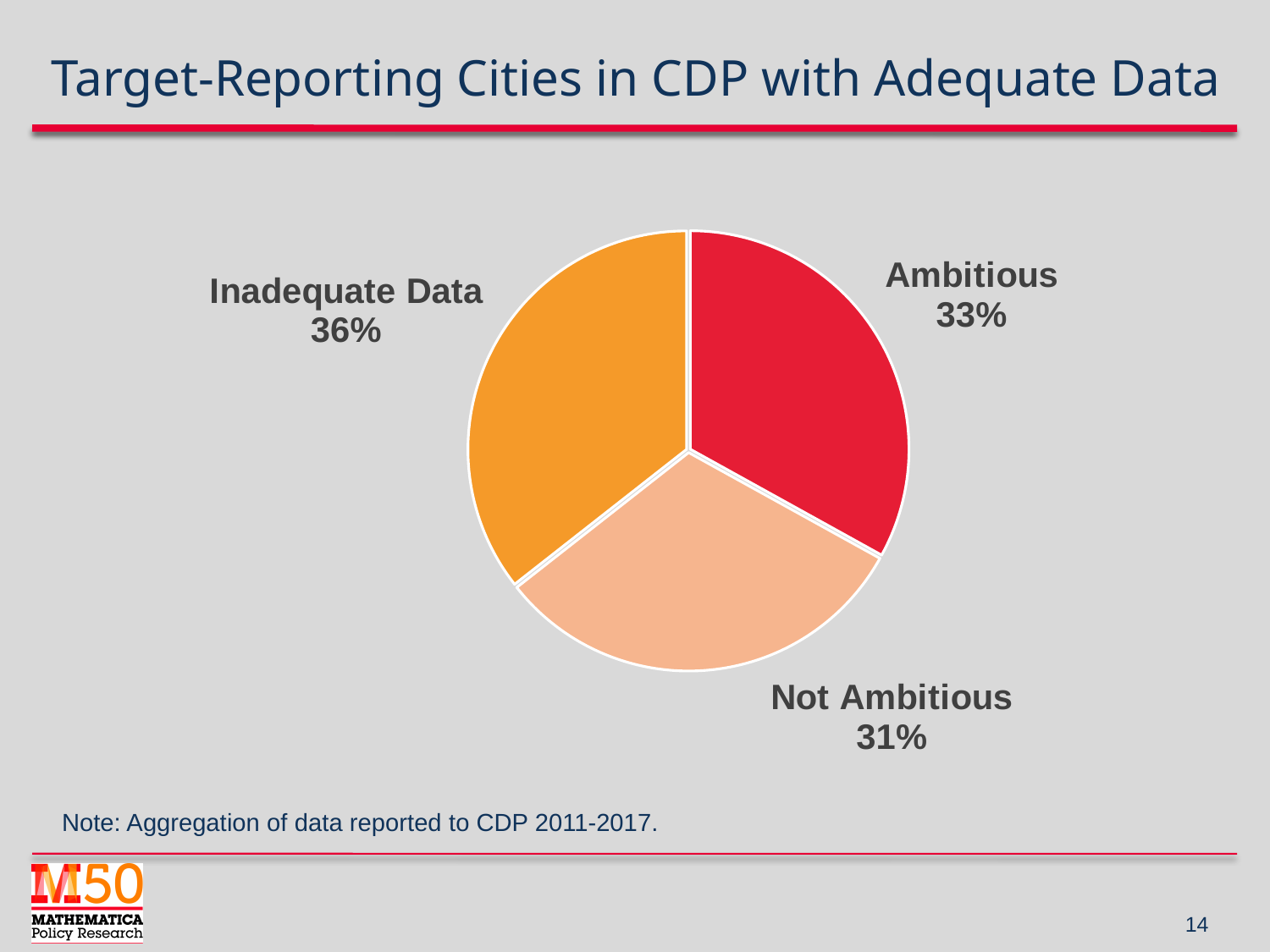
Which slice of the pie is the smallest? Not Ambitious What type of chart is shown on the slide? Pie chart Which slice of the pie is the largest? Inadequate Data What colour is the Ambitious slice of the pie? Red What share of the pie is labelled Ambitious? 33% What is the difference in percentage points between the Ambitious slice and the Not Ambitious slice? 2 percentage points Which is larger, the Ambitious slice or the Inadequate Data slice? Inadequate Data What share of the pie is labelled Inadequate Data? 36% What is the difference in percentage points between the Inadequate Data slice and the Not Ambitious slice? 5 percentage points What is the title of the chart on the slide? Target-Reporting Cities in CDP with Adequate Data How many slices does the pie chart have? 3 What share of the pie is labelled Not Ambitious? 31%